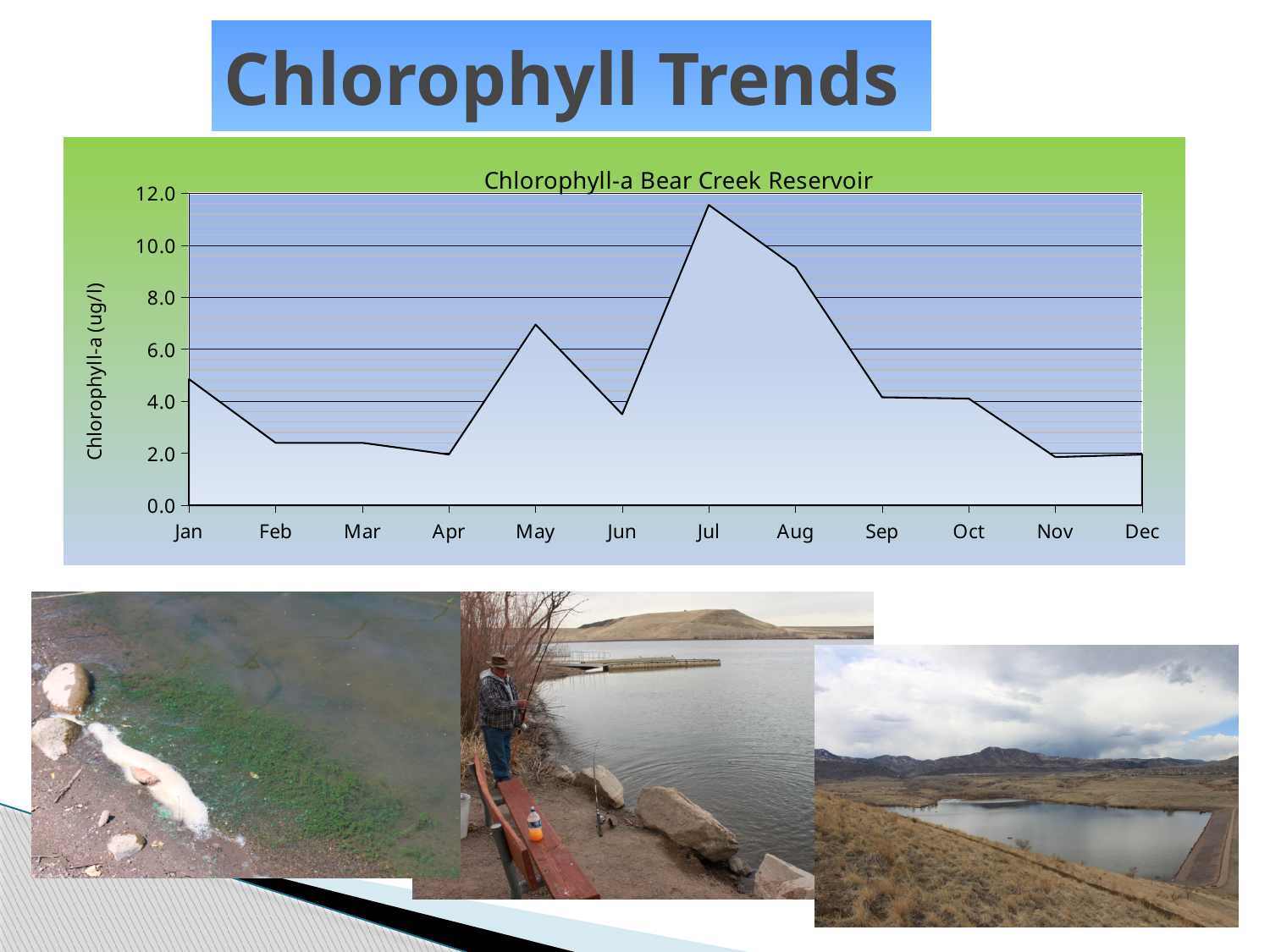
What is the title of the chart? Chlorophyll-a Bear Creek Reservoir What is the label of the y axis? Chlorophyll-a (ug/l) Is the chlorophyll-a value for May greater or less than 6.0? greater Is the chlorophyll-a value for Aug greater or less than 8.0? greater Do the chlorophyll-a values rise or fall from Jul to Nov? fall What kind of chart is shown on the slide? area chart Which month has the highest chlorophyll-a value? Jul Is the chlorophyll-a value for Jul greater or less than 10.0? greater Which month has the larger chlorophyll-a value, Jan or Feb? Jan Which month has the larger chlorophyll-a value, May or Jun? May How many months are plotted along the x axis? 12